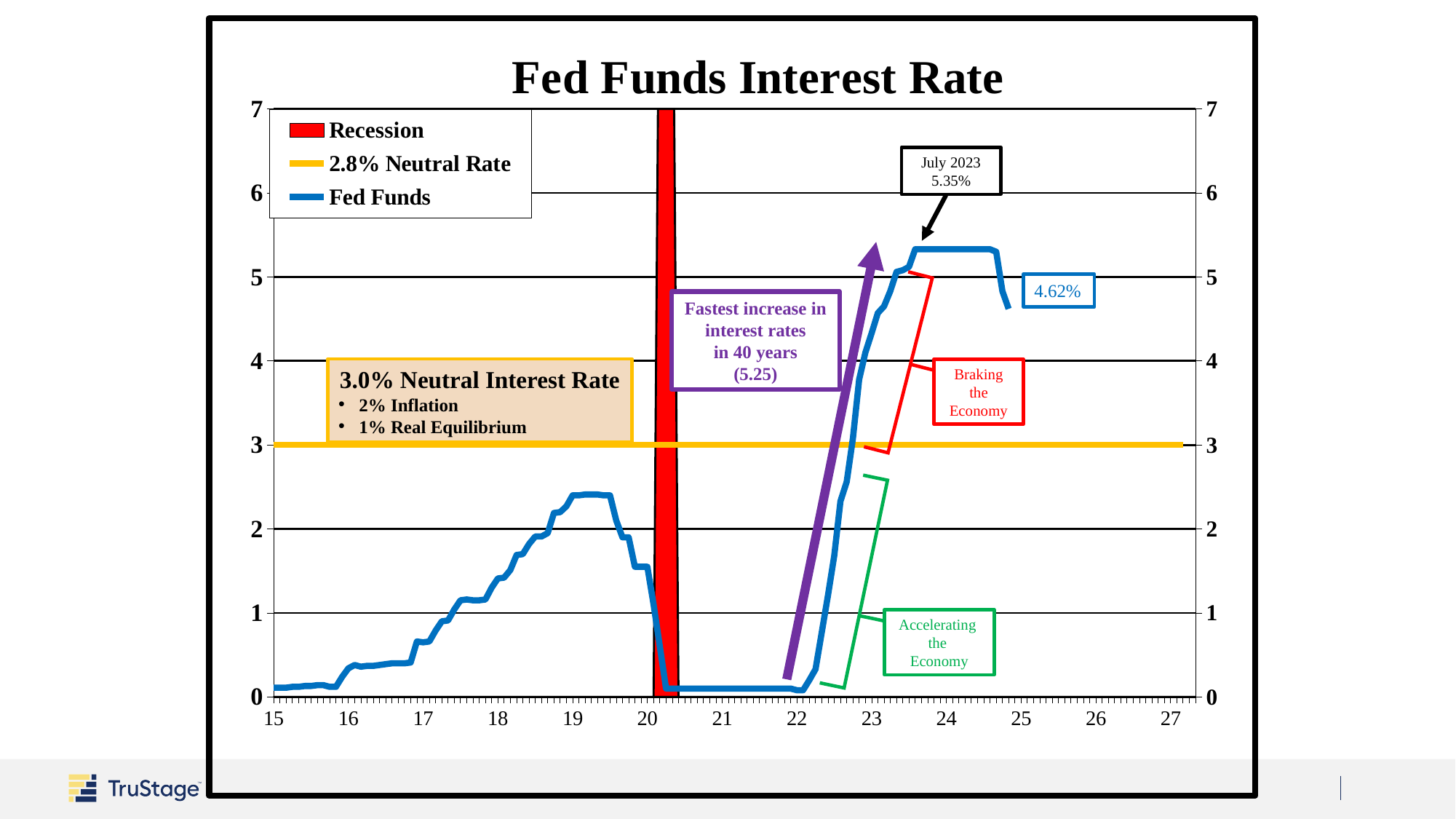
What kind of chart is shown on the slide? line chart Is the Fed Funds rate in 2021 greater or less than 1? less What value is labeled at the end of the Fed Funds line? 4.62% Is the Fed Funds rate in 2024 greater or less than 5? greater How many entries does the chart's legend list? 3 Which is larger, the July 2023 Fed Funds rate or the labeled 4.62% end value? July 2023 rate Is the Fed Funds rate in 2019 greater or less than 3? less What neutral rate value is given in the chart's legend? 2.8% Does the Fed Funds line rise or fall between 2022 and 2023? rise What is the difference between the July 2023 rate of 5.35% and the labeled end value of 4.62%? 0.73% What is the title of the chart? Fed Funds Interest Rate What Fed Funds rate is labeled for July 2023? 5.35%